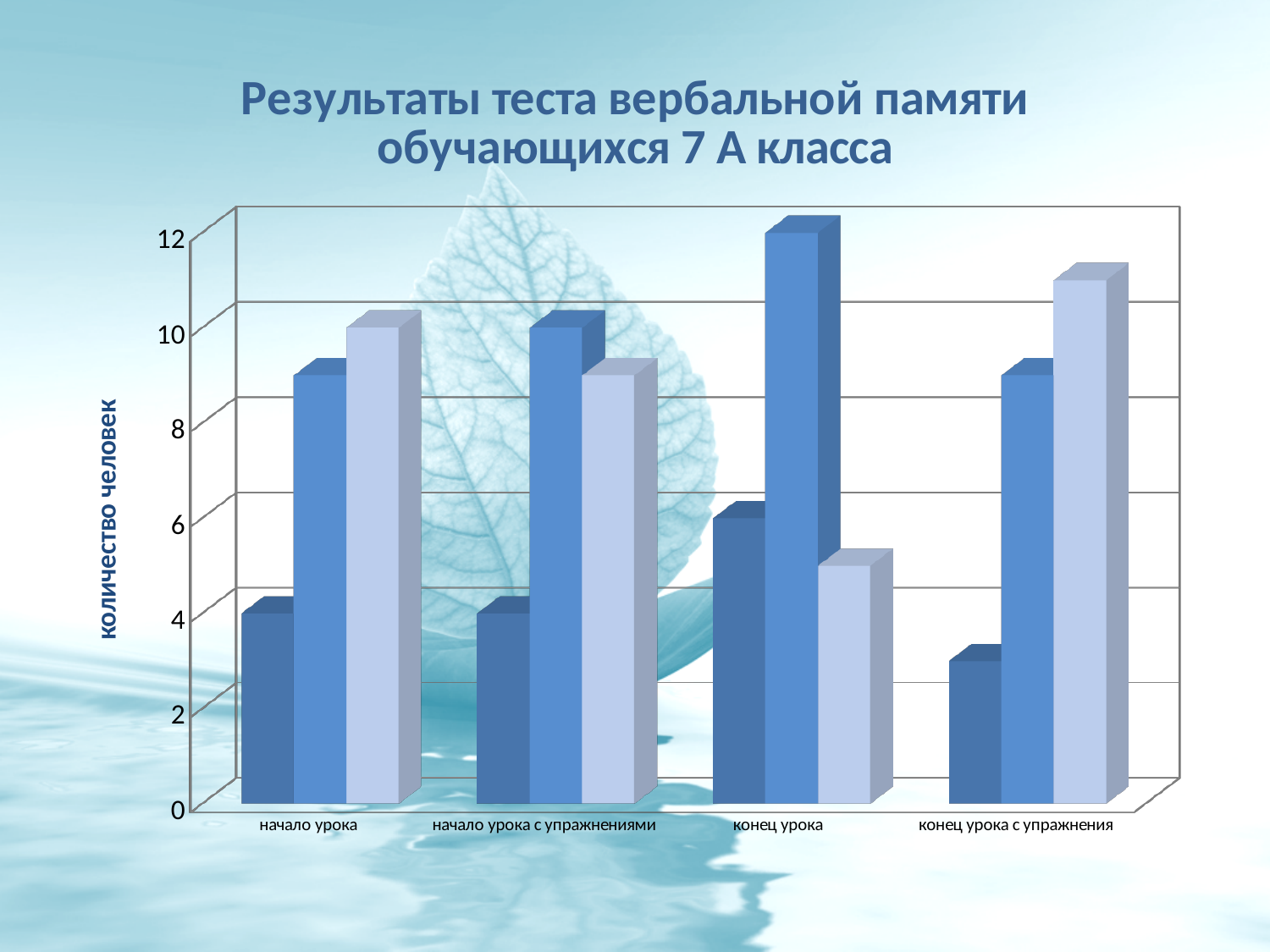
Which category has the taller light blue bar: "начало урока" or "конец урока"? начало урока How many categories are shown along the x axis of the chart? 4 Is the value of the light blue bar for "конец урока с упражнения" greater or less than 10? greater In which category is the dark blue bar the shortest? конец урока с упражнения What kind of chart is shown on the slide? bar chart Is the value of the medium blue bar for "конец урока" greater or less than 10? greater What is the label of the vertical axis of the chart? количество человек In which category is the medium blue bar the tallest? конец урока For "конец урока", which bar is taller: the medium blue bar or the light blue bar? the medium blue bar Is the value of the dark blue bar for "конец урока с упражнения" greater or less than 4? less What is the title of the chart on the slide? Результаты теста вербальной памяти обучающихся 7 А класса